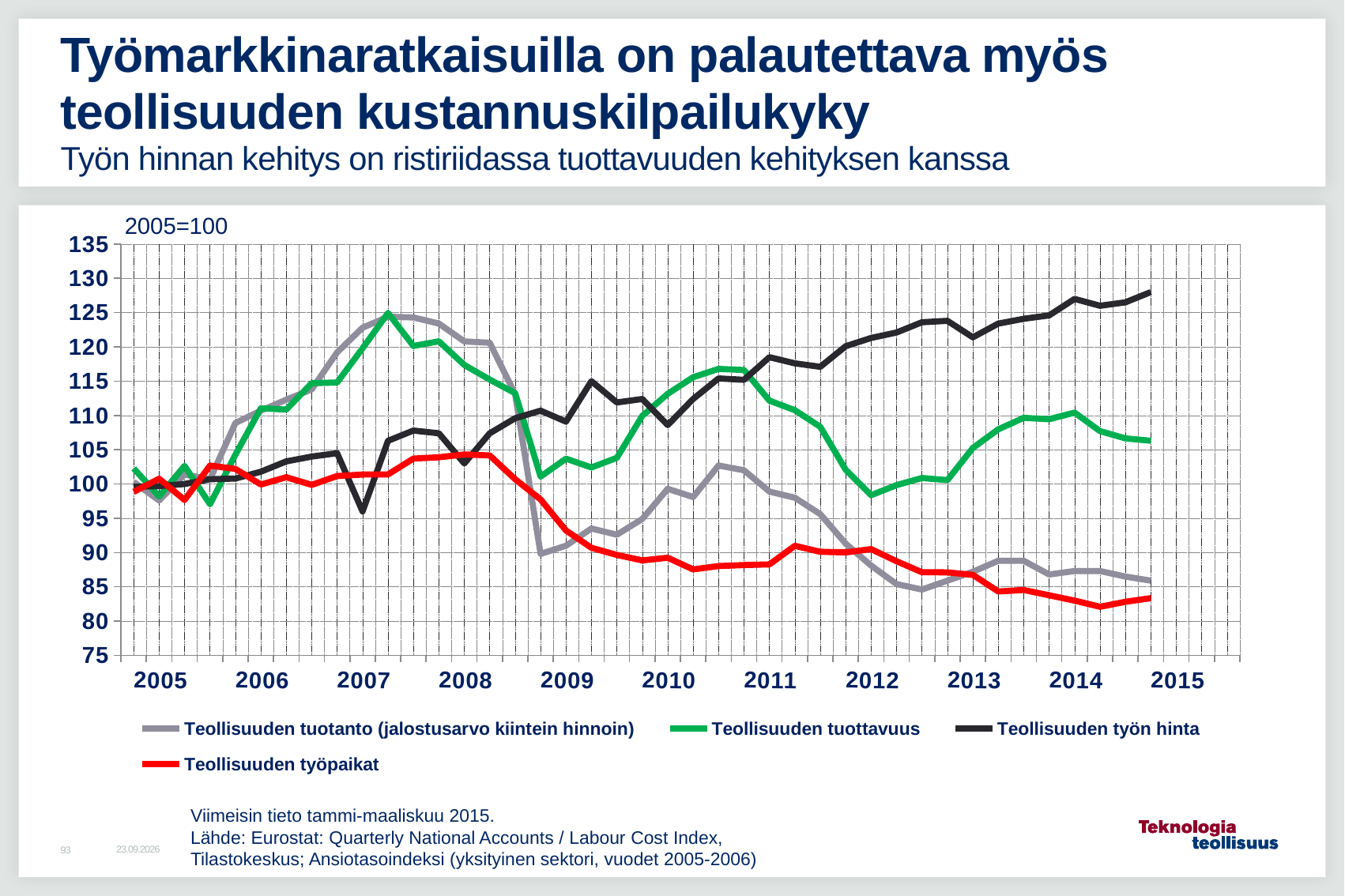
Which series does the legend show in green? Teollisuuden tuottavuus At the end of the series (2015), which is higher: Teollisuuden työn hinta or Teollisuuden tuottavuus? Teollisuuden työn hinta Does the Teollisuuden työn hinta series rise or fall overall from 2005 to 2015? rises What base year and index value is stated above the chart? 2005=100 Which series has the lowest value at the end of the series (2015)? Teollisuuden työpaikat Is the value for Teollisuuden työn hinta at the end of the series (2015) greater or less than 125? greater What kind of chart is shown on the slide? line chart How many series does the legend list? 4 Is the value for Teollisuuden tuotanto (jalostusarvo kiintein hinnoin) at the end of the series (2015) greater or less than 90? less Does the Teollisuuden työpaikat series rise or fall overall from 2008 to 2015? falls Is the value for Teollisuuden työpaikat at the end of the series (2015) greater or less than 85? less